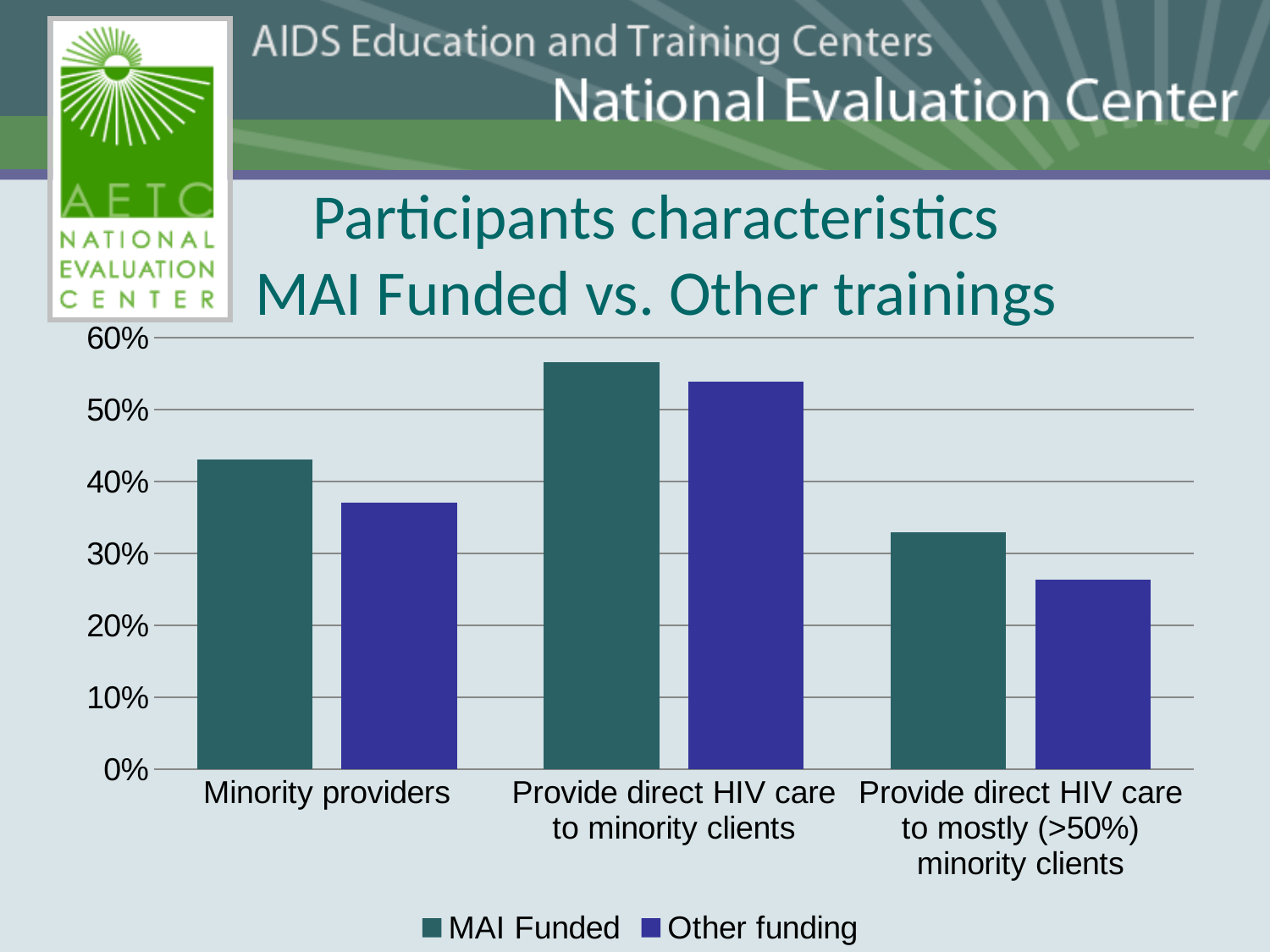
For Minority providers, which series has the larger value, MAI Funded or Other funding? MAI Funded Is the MAI Funded value for Minority providers greater or less than 40%? greater Is the Other funding value for Provide direct HIV care to mostly (>50%) minority clients greater or less than 30%? less How many series does the legend list? 2 How many categories are shown on the x axis? 3 Which category has the highest value for MAI Funded? Provide direct HIV care to minority clients Is the MAI Funded value for Provide direct HIV care to minority clients greater or less than 50%? greater What is the title of the chart? Participants characteristics MAI Funded vs. Other trainings What kind of chart is shown on the slide? bar chart Which category has the lowest value for Other funding? Provide direct HIV care to mostly (>50%) minority clients For Provide direct HIV care to mostly (>50%) minority clients, which series has the larger value, MAI Funded or Other funding? MAI Funded